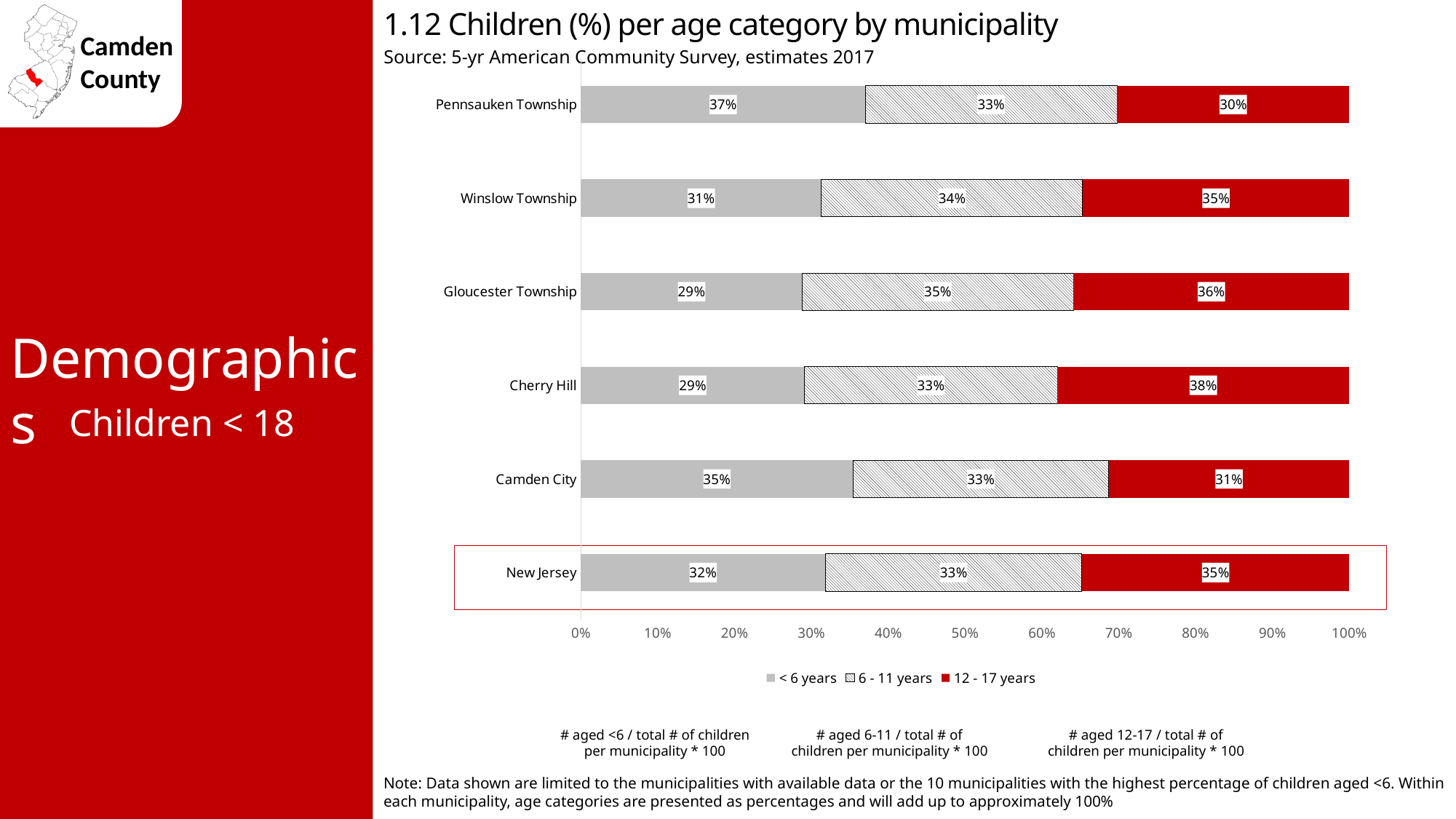
What is the value for the 12 - 17 years series for Cherry Hill? 38% What is the total of the stacked bar for Winslow Township? 100% What is the difference between the < 6 years percentage for Camden City and for New Jersey? 3% What percentage of children in Gloucester Township are aged 6 - 11 years? 35% Which series is shown in red? 12 - 17 years How many municipalities or regions are shown on the chart? 6 What kind of chart is shown on the slide? Stacked bar chart How many series does the legend list? 3 What percentage of children in Pennsauken Township are under 6 years old? 37% Which category has the lowest percentage of children aged 12 - 17 years? Pennsauken Township Which is larger: the 12 - 17 years share for Winslow Township or for Camden City? Winslow Township Which municipality has the highest percentage of children under 6 years? Pennsauken Township